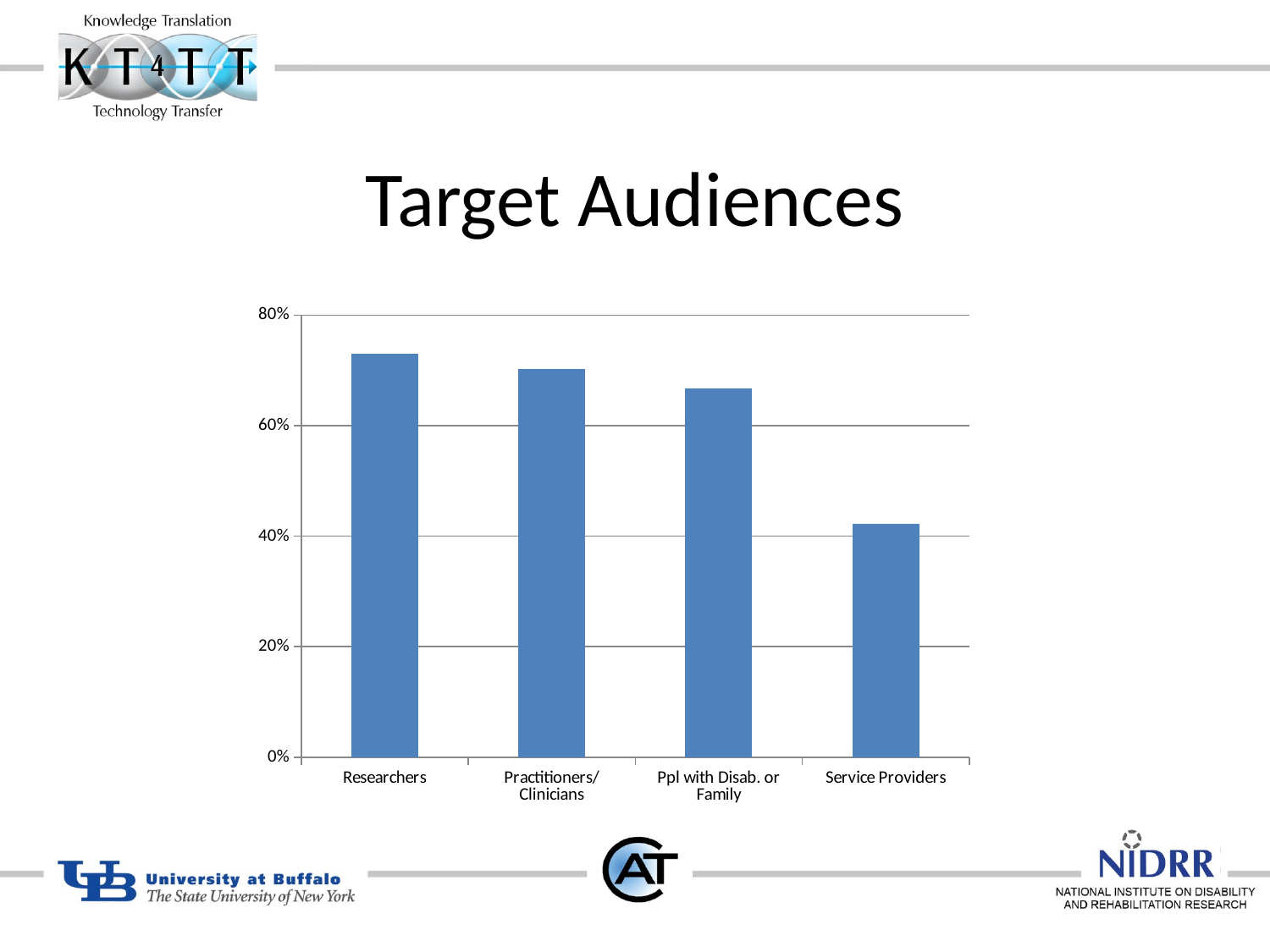
Is the value for Practitioners/Clinicians greater or less than 80%? less Is the value for Ppl with Disab. or Family greater or less than 60%? greater How many categories are shown on the x axis of the chart? 4 Is the value for Service Providers greater or less than 60%? less What is the title of the slide containing the chart? Target Audiences Which is larger, the value for Ppl with Disab. or Family or the value for Service Providers? Ppl with Disab. or Family Which is larger, the value for Researchers or the value for Service Providers? Researchers Which category has the lowest value in the chart? Service Providers What kind of chart is shown on the slide? bar chart Do the bar values rise or fall from left to right along the x axis? fall